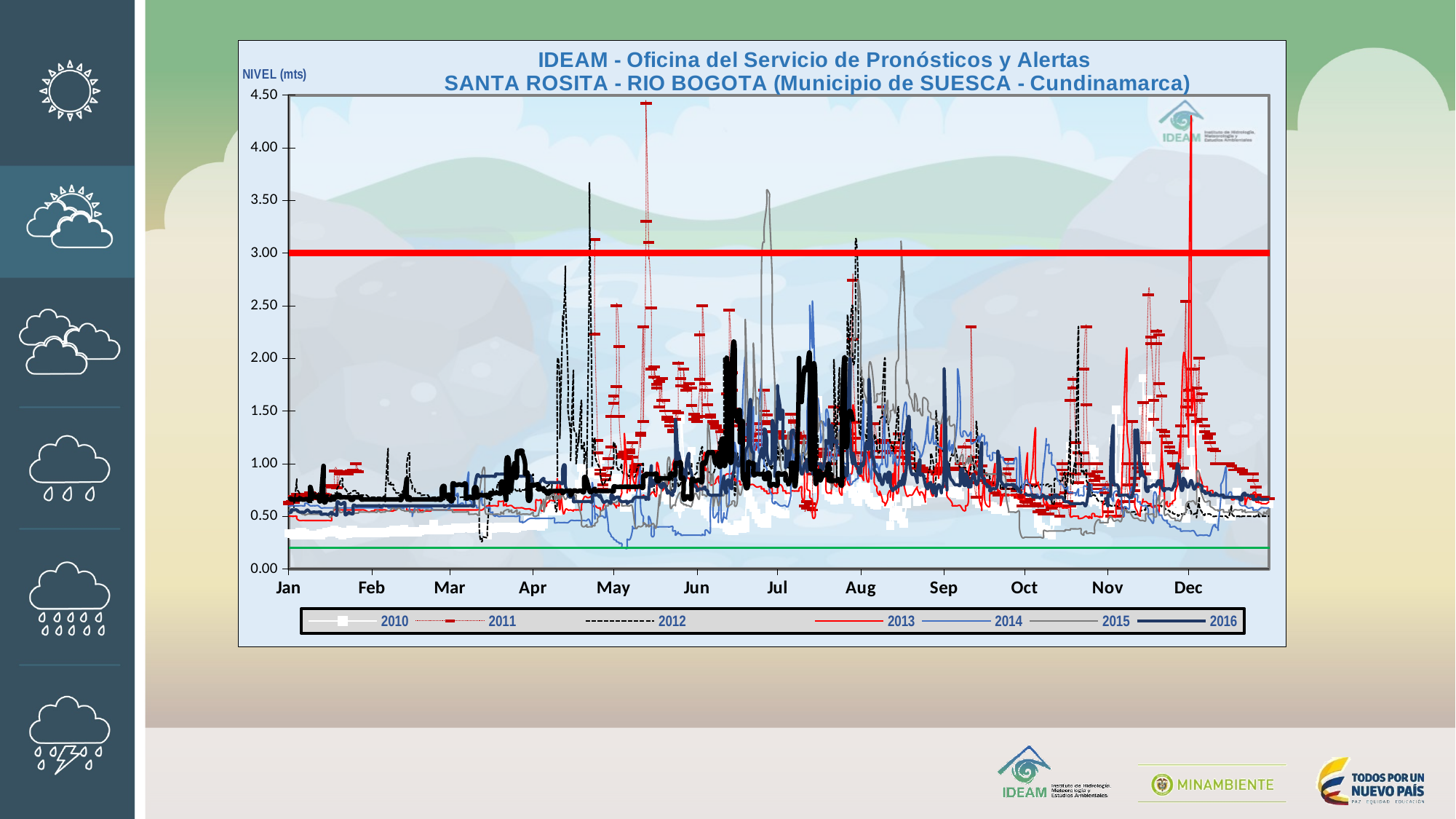
What kind of chart is shown on the slide? line chart Is the peak value of the 2013 series in December greater or less than 4.00? greater Is the value of the 2016 series in January greater or less than 1.00? less Is the peak value of the 2011 series in May greater or less than 4.00? greater What is the label of the y axis? NIVEL (mts) How many months are labelled along the x axis? 12 How many series does the legend list? 7 What is the highest value shown on the y axis? 4.50